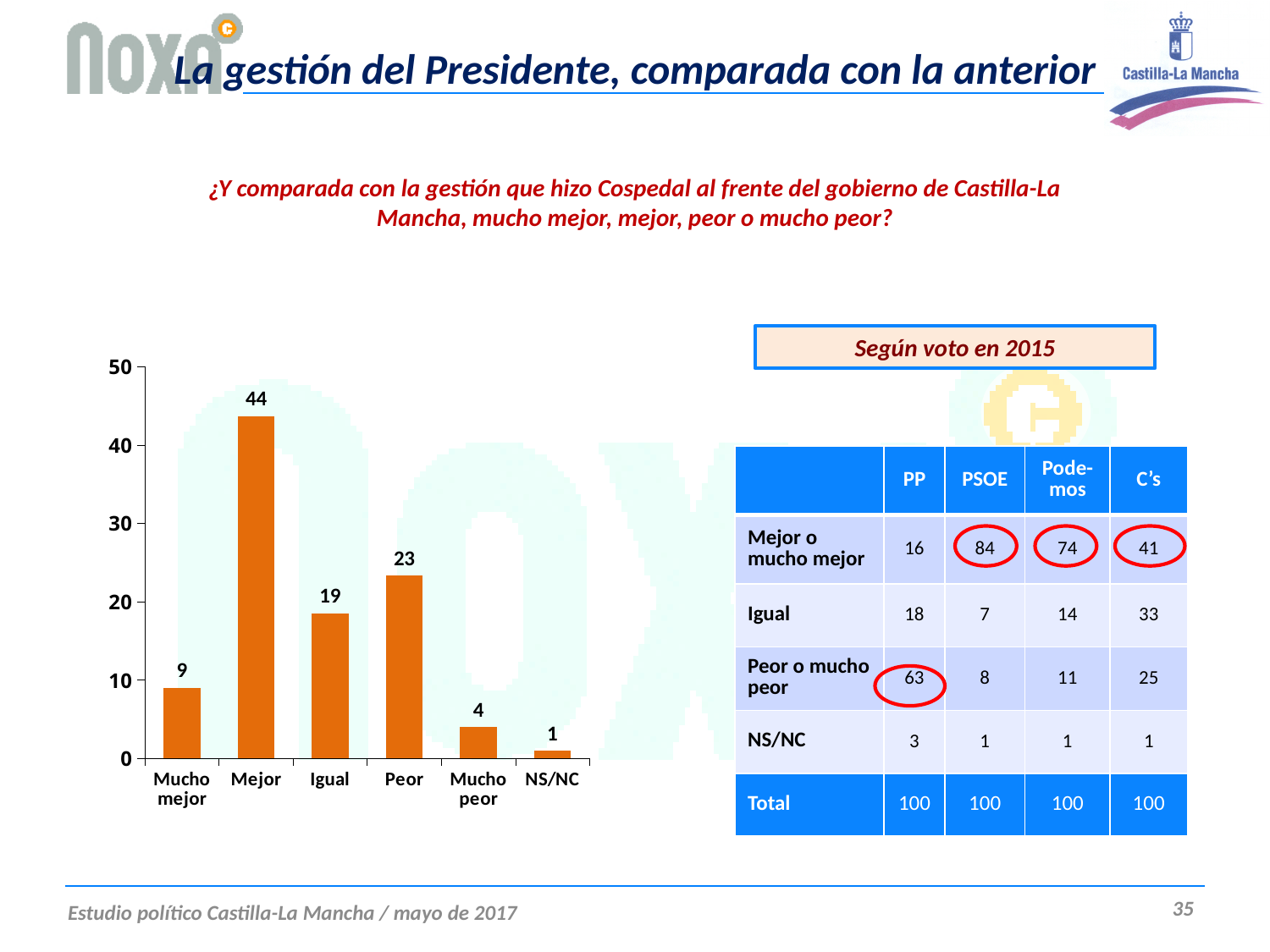
What is the value for "Peor" in the bar chart? 23 What is the value for "Mejor" in the bar chart? 44 Which is larger in the bar chart, the value for "Igual" or the value for "Peor"? Peor What is the difference between the values for "Mejor" and "Peor" in the bar chart? 21 What is the value for "Mucho mejor" in the bar chart? 9 What kind of chart is shown on the slide? bar chart What is the difference between the values for "Igual" and "Mucho peor" in the bar chart? 15 Which category has the lowest value in the bar chart? NS/NC Is the value for "Mejor" in the bar chart greater or less than 40? greater What is the value for "NS/NC" in the bar chart? 1 Which category has the highest value in the bar chart? Mejor How many categories are shown in the bar chart? 6